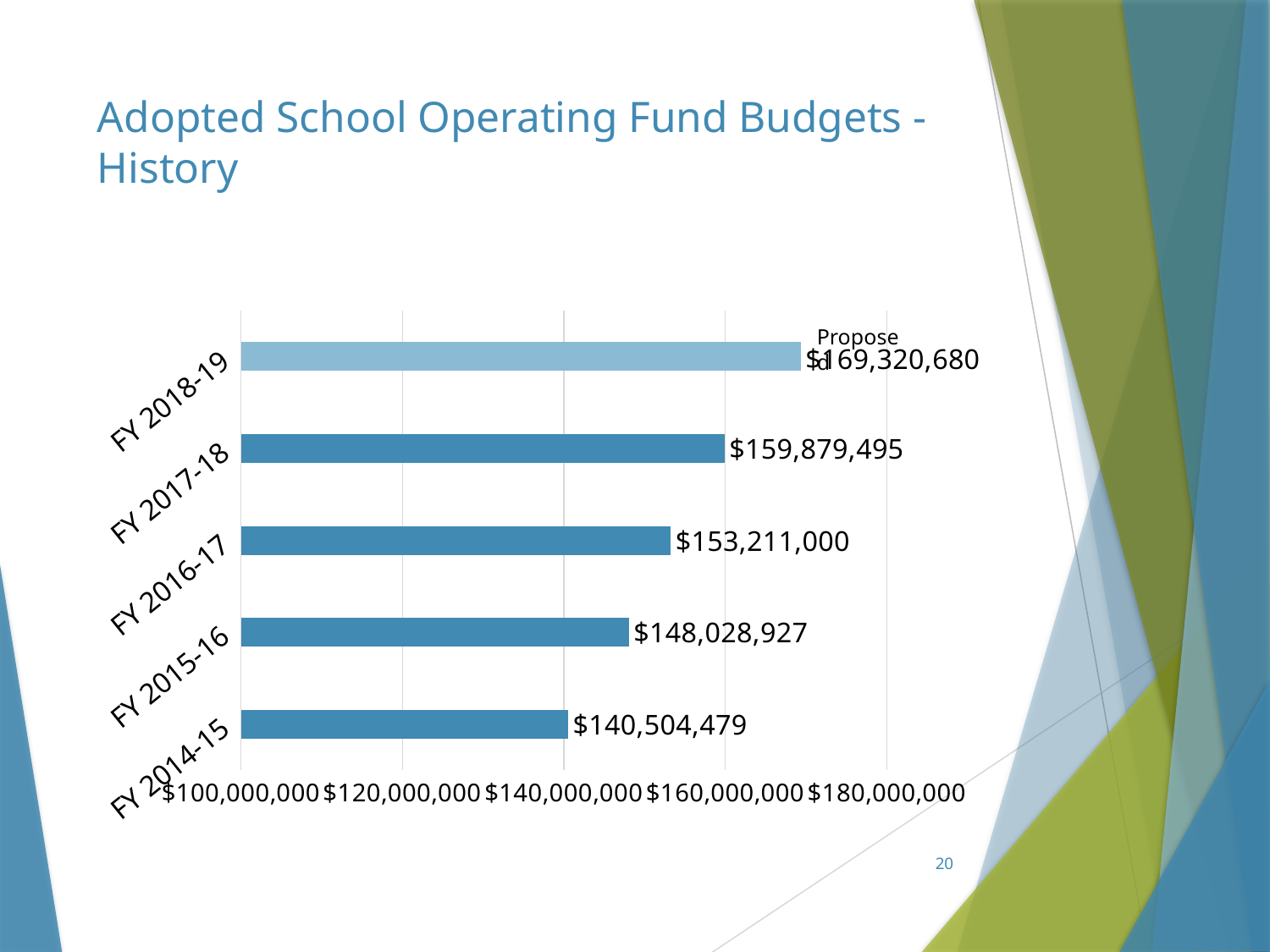
Is the value for FY 2017-18 greater or less than $160,000,000? less What type of chart is shown on the slide? bar chart Which is larger, the value for FY 2016-17 or the value for FY 2015-16? FY 2016-17 What is the proposed budget value for FY 2018-19? $169,320,680 What is the value shown for FY 2017-18? $159,879,495 What is the value shown for FY 2014-15? $140,504,479 How many fiscal years are shown in the chart? 5 What is the difference between the FY 2015-16 value and the FY 2014-15 value? $7,524,448 Which fiscal year has the lowest budget value? FY 2014-15 What is the adopted budget value for FY 2016-17? $153,211,000 Which fiscal year has the highest budget value? FY 2018-19 What is the difference between the FY 2018-19 value and the FY 2017-18 value? $9,441,185